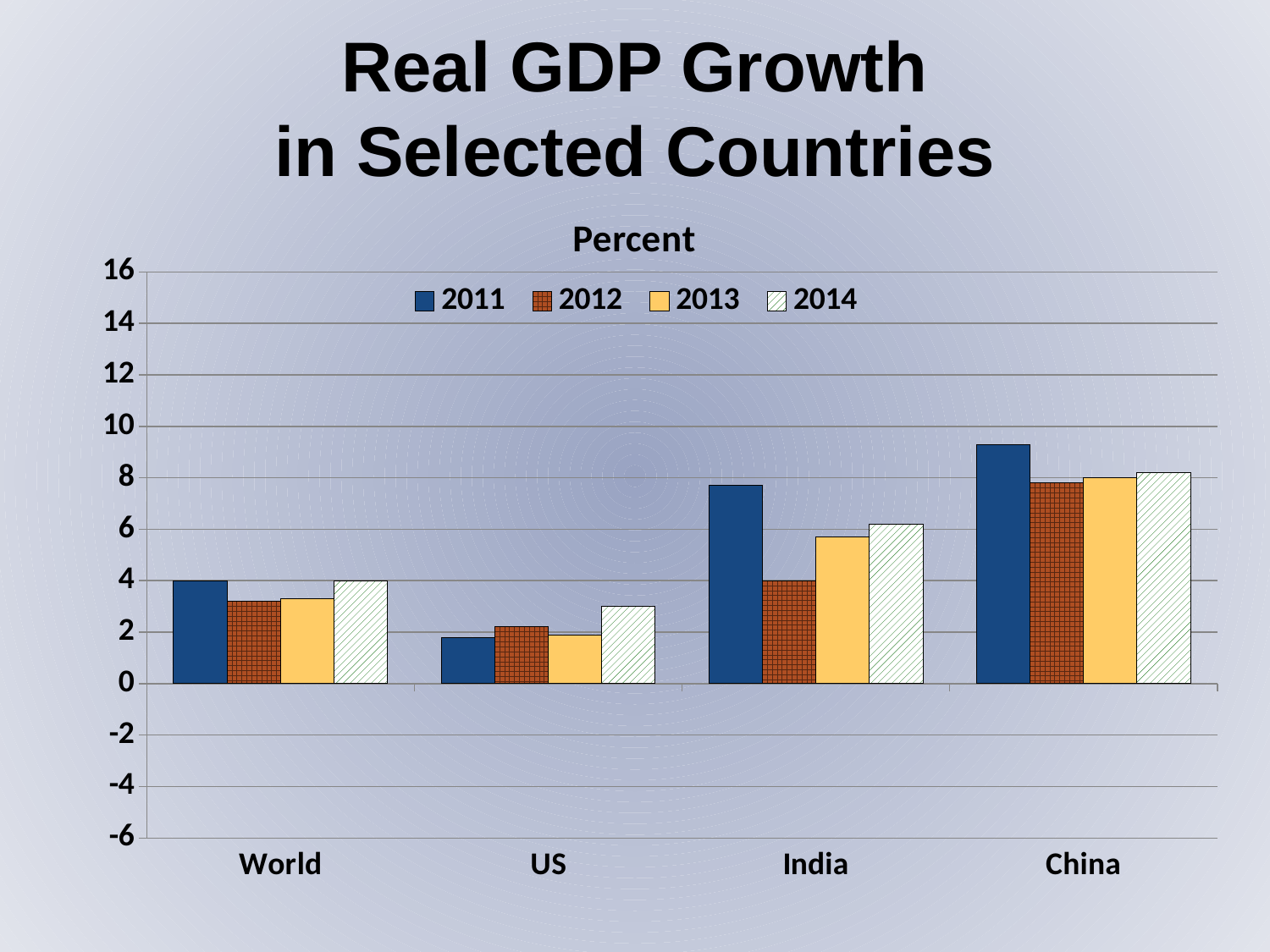
Which country or region has the lowest real GDP growth in 2011? US Which country or region has the highest real GDP growth in 2011? China Which is larger: China's 2012 value or India's 2014 value? China's 2012 value How many series does the legend list? 4 Is the 2012 value for India greater or less than 6? less How many countries or regions are shown on the x axis? 4 Which is larger for India: the 2011 value or the 2012 value? 2011 Is the 2011 value for China greater or less than 8? greater Which country or region has the lowest real GDP growth in 2012? US What kind of chart is shown on the slide? bar chart What unit label is shown above the chart? Percent Is the 2014 value for US greater or less than 2? greater